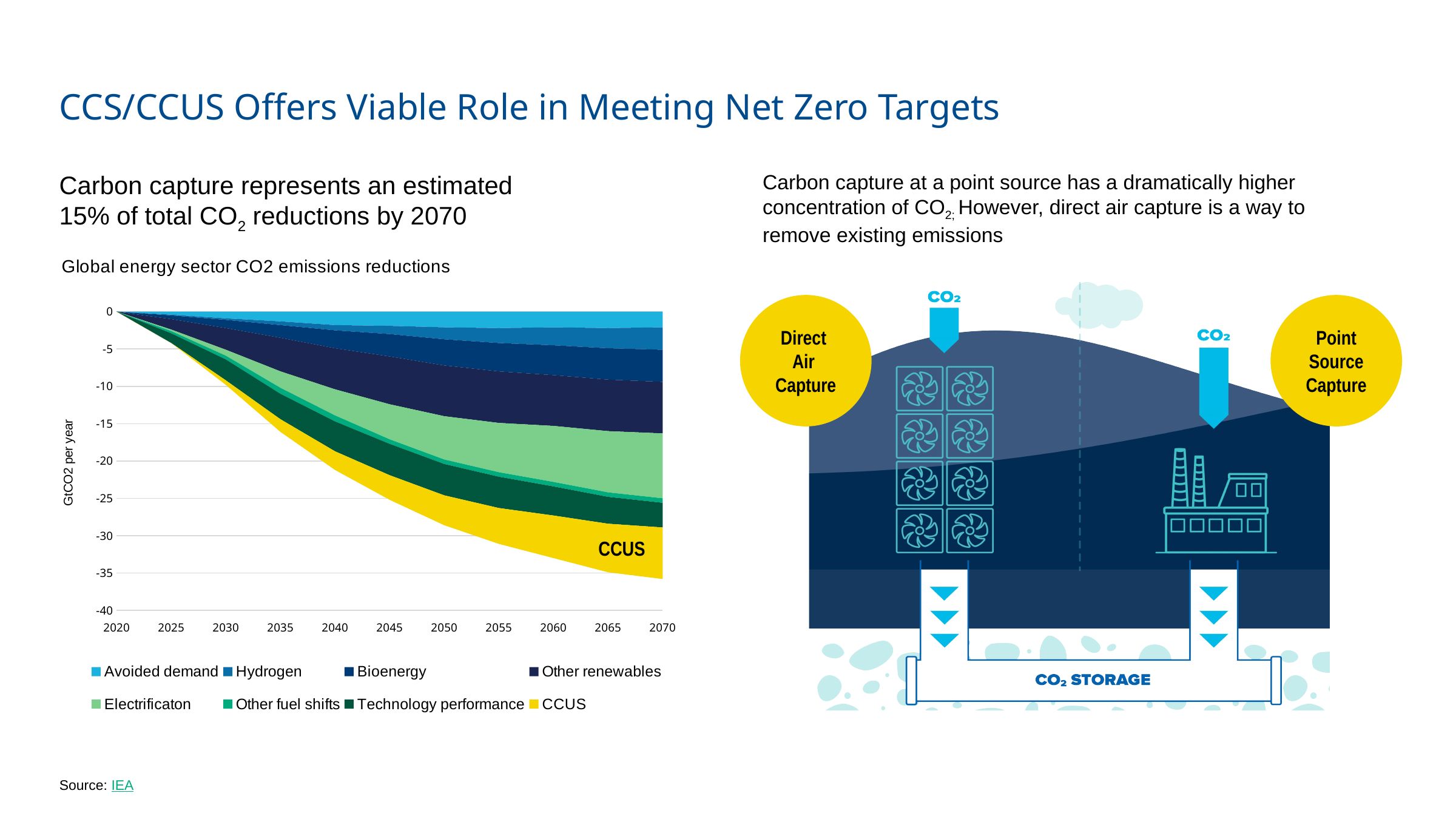
How many year labels are shown on the x axis of the emissions reductions chart? 11 What is the lowest value shown on the y axis of the emissions reductions chart? -40 What is the y-axis label of the emissions reductions chart? GtCO2 per year What kind of chart is used to show the global energy sector CO2 emissions reductions? Area chart At 2070, does the bottom edge of the stacked area lie above or below the -30 gridline? Below What is the last year shown on the x axis of the emissions reductions chart? 2070 How many series does the legend of the emissions reductions chart list? 8 Do the stacked emissions reduction values rise or fall (become more negative) from 2020 to 2070? Fall What is the total emissions reduction value at 2020 in the chart? 0 Which series is labelled directly on the chart area in the emissions reductions chart? CCUS At 2060, does the bottom edge of the stacked area lie above or below the -30 gridline? Below What is the first year shown on the x axis of the emissions reductions chart? 2020